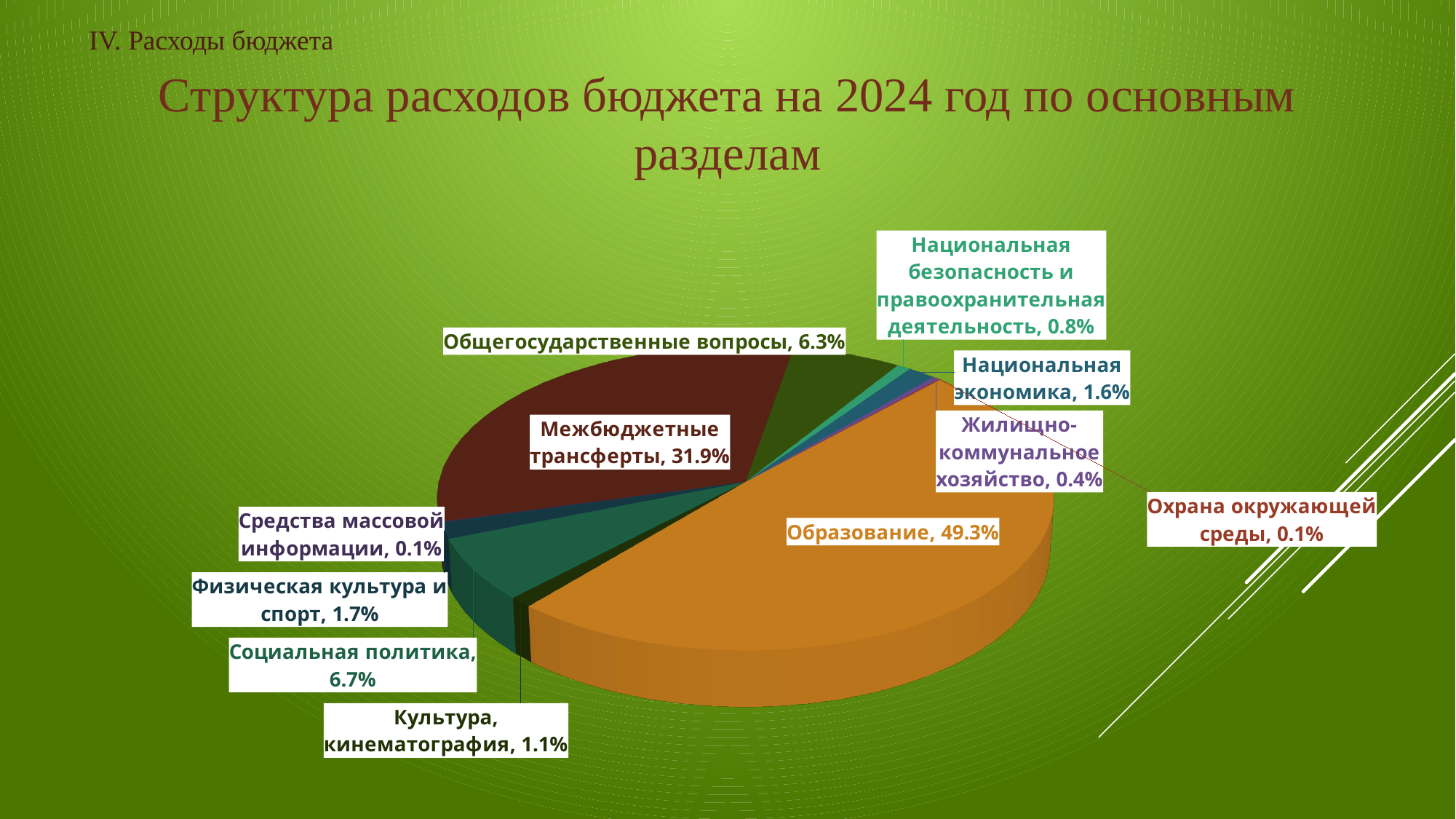
What share of the budget expenditure goes to Образование? 49.3% What is the value shown for Межбюджетные трансферты? 31.9% What is the difference between the shares of Физическая культура и спорт and Культура, кинематография? 0.6% Which section has the largest share of the budget expenditure? Образование What is the difference between the shares of Образование and Межбюджетные трансферты? 17.4% How many sections (slices) are shown in the pie chart? 11 What percentage is shown for Социальная политика? 6.7% What is the value for Национальная безопасность и правоохранительная деятельность? 0.8% What is the title of the chart on the slide? Структура расходов бюджета на 2024 год по основным разделам Which is larger, the share for Общегосударственные вопросы or the share for Социальная политика? Социальная политика What kind of chart is shown on the slide? Pie chart What percentage is shown for Жилищно-коммунальное хозяйство? 0.4%